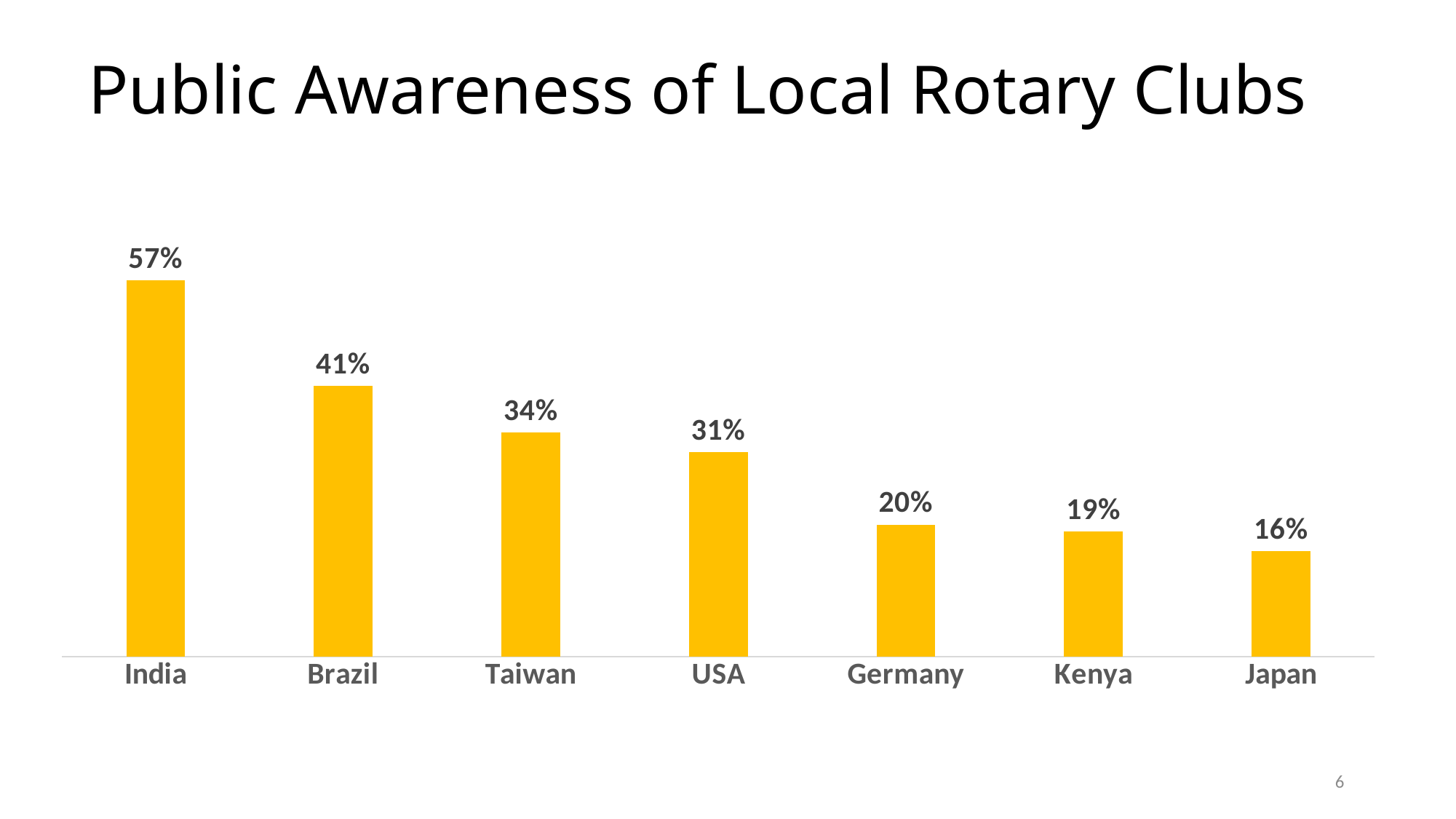
What is the difference between the values for India and Brazil? 16% Which country has the highest public awareness of local Rotary clubs? India What is the public awareness value for Japan? 16% What kind of chart is shown on the slide? Bar chart Do the values rise or fall from left to right across the countries? Fall How many countries are shown in the chart? 7 Which is larger, the value for Brazil or the value for Taiwan? Brazil What is the public awareness value for India? 57% What is the difference between the values for Taiwan and USA? 3% What is the title of the chart? Public Awareness of Local Rotary Clubs What is the public awareness value for Germany? 20% Which country has the lowest public awareness of local Rotary clubs? Japan